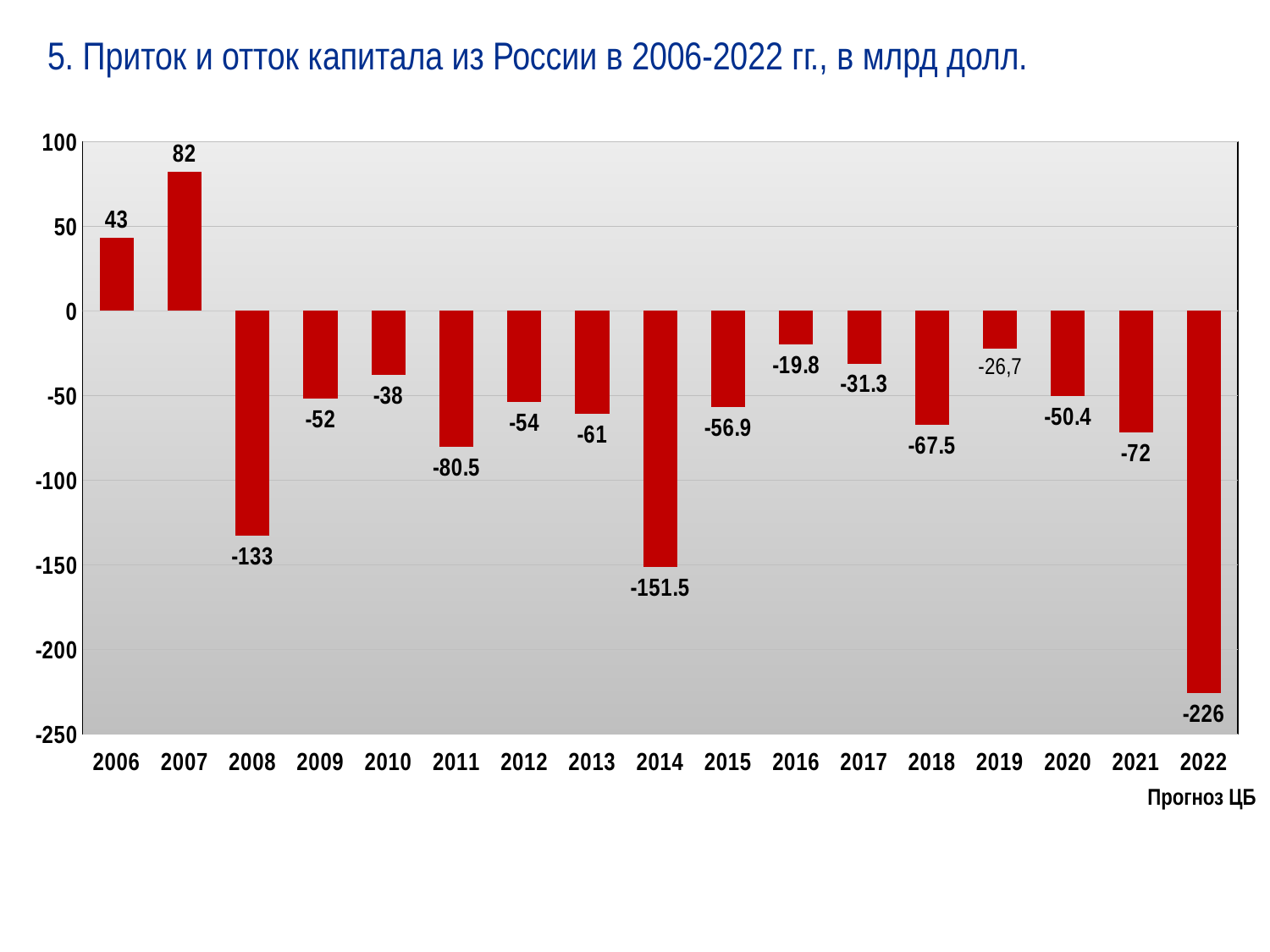
What is the value for 2007? 82 Which year has the lowest value? 2022 How many years are shown on the x axis? 17 Which is larger, the value for 2016 or the value for 2017? 2016 What is the difference between the values for 2007 and 2006? 39 What is the value for 2014? -151.5 What is the value for 2022? -226 What kind of chart is this? bar chart What is the value for 2019? -26,7 What is the title of the chart? 5. Приток и отток капитала из России в 2006-2022 гг., в млрд долл. Which year has the highest value? 2007 How many years have a positive value? 2